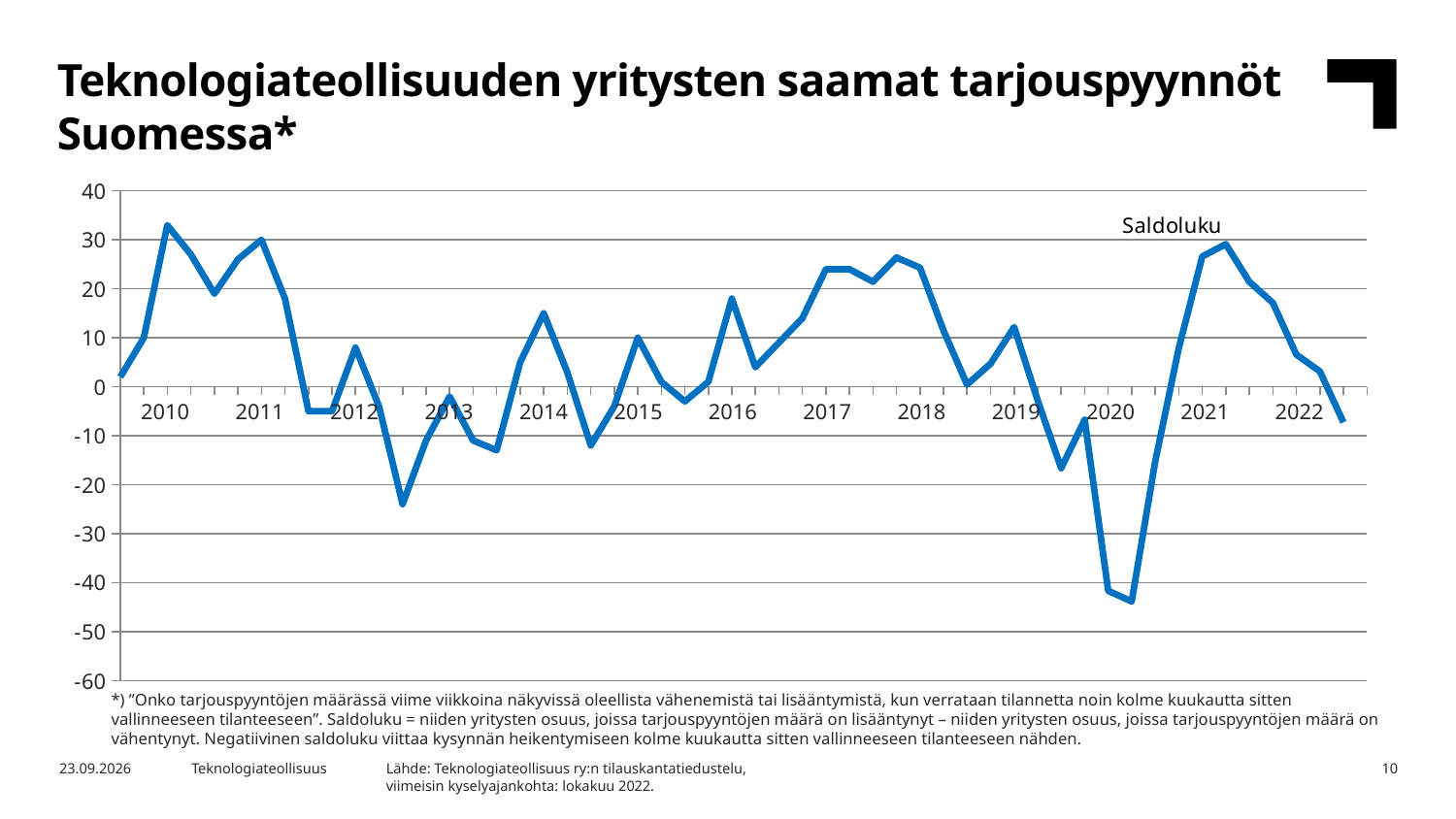
Is the lowest value of the line in 2020 greater or less than -30? less Is the lowest value of the line in 2012 greater or less than -10? less What is the name of the series plotted in the chart? Saldoluku Is the last plotted value at the end of 2022 greater or less than 0? less How many series does the chart plot? 1 What kind of chart is shown on the slide? line chart In which year does the line reach its lowest point? 2020 From the 2021 peak to the end of 2022, do the values rise or fall? fall What is the title of the chart on the slide? Teknologiateollisuuden yritysten saamat tarjouspyynnöt Suomessa* How many years are labelled on the x axis? 13